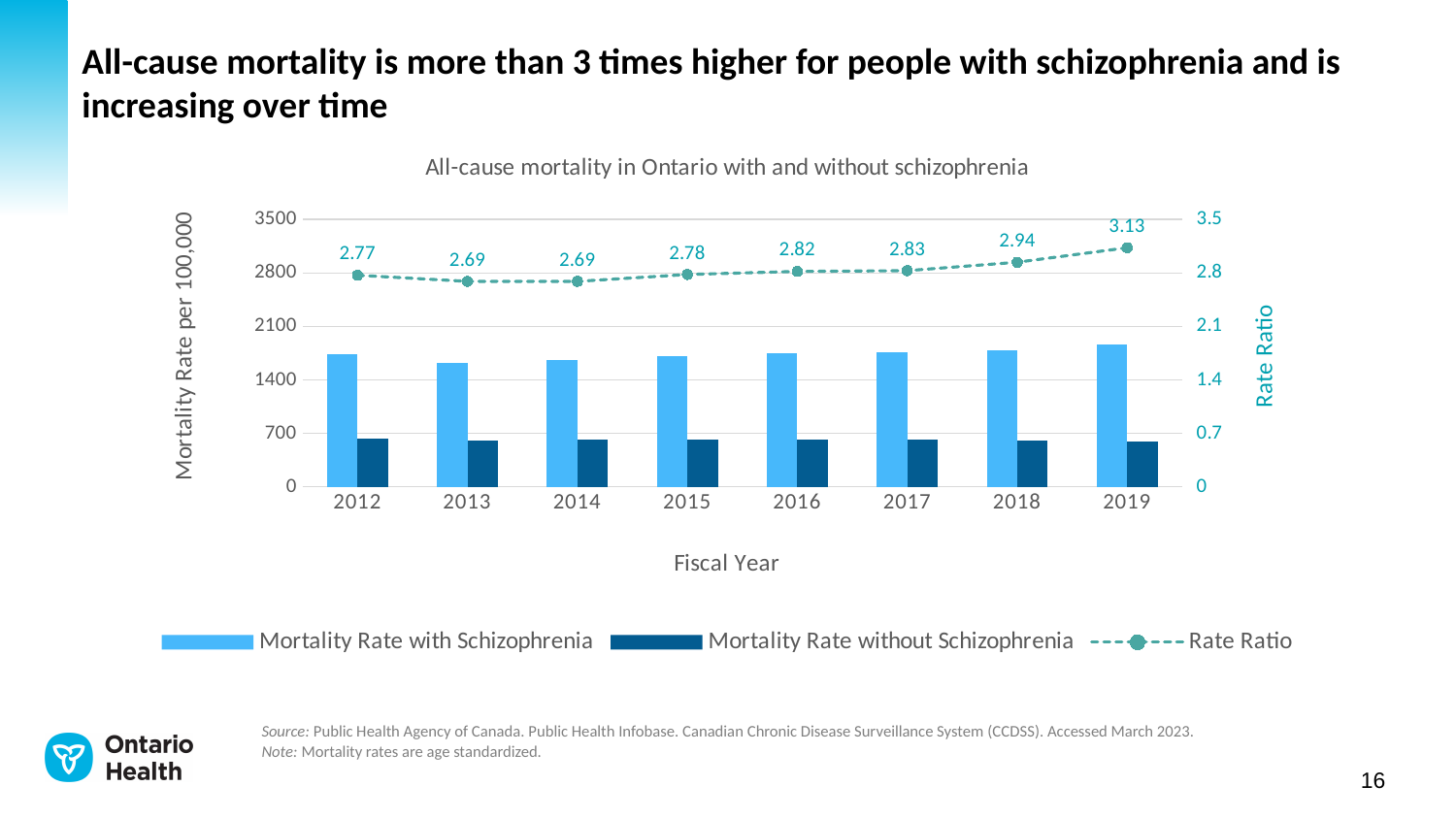
How many fiscal years are shown on the x axis? 8 How many series does the legend list? 3 What is the Rate Ratio for fiscal year 2012? 2.77 Is the Mortality Rate with Schizophrenia in 2019 greater or less than 1400? greater What is the difference between the Rate Ratio in 2018 and in 2017? 0.11 Is the Mortality Rate without Schizophrenia in 2012 greater or less than 700? less Does the Rate Ratio rise or fall from 2014 to 2019? rise What is the Rate Ratio for fiscal year 2019? 3.13 Which is larger, the Rate Ratio in 2015 or the Rate Ratio in 2013? 2015 What is the difference between the Rate Ratio in 2019 and the Rate Ratio in 2012? 0.36 What is the Rate Ratio for fiscal year 2016? 2.82 In which fiscal year is the Rate Ratio highest? 2019